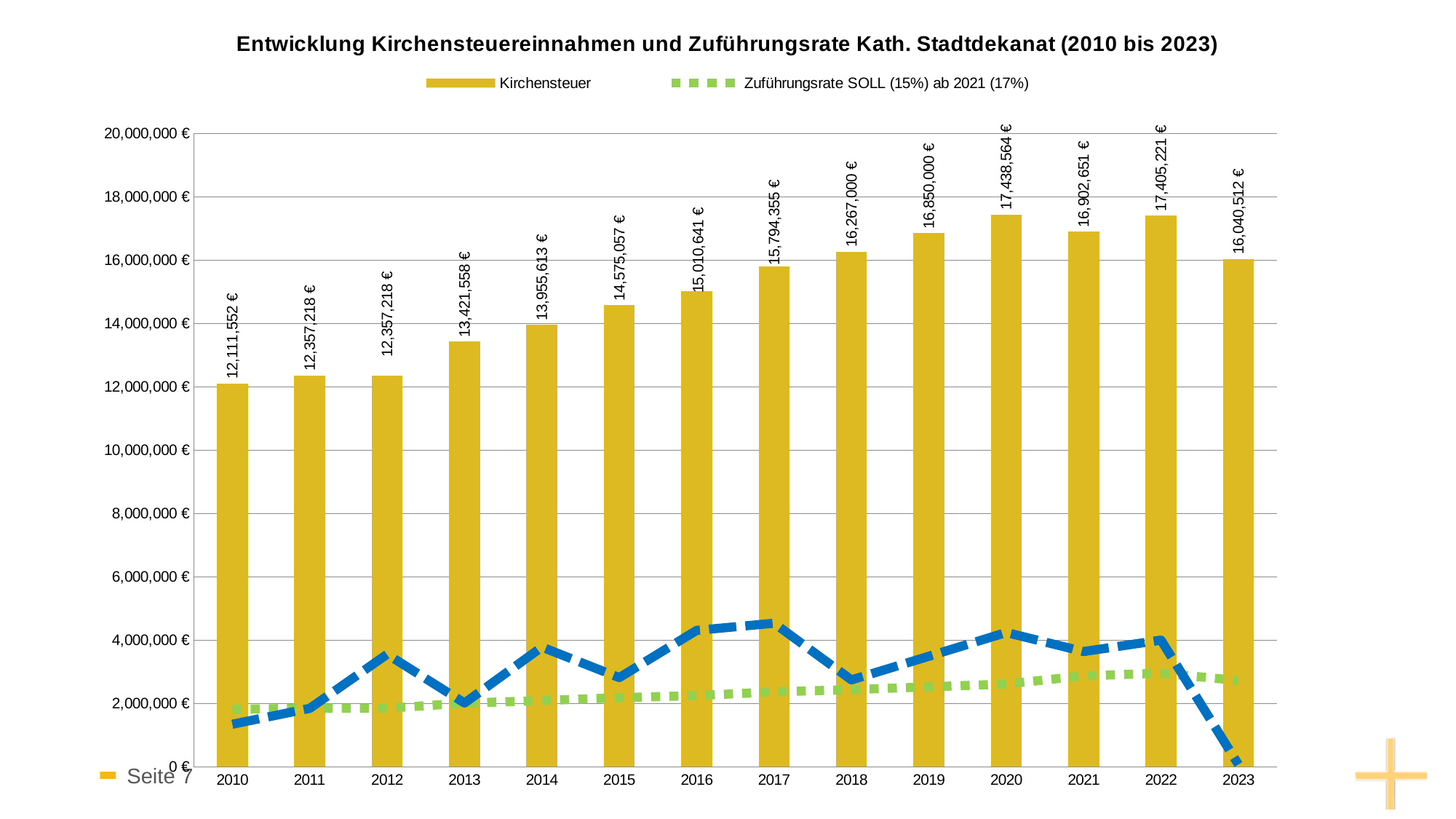
What is the difference between the Kirchensteuer values for 2020 and 2010? 5,327,012 € How many years are shown on the x axis? 14 Which year has the larger Kirchensteuer value, 2021 or 2022? 2022 What is the Kirchensteuer value for 2010? 12,111,552 € What is the Kirchensteuer value for 2023? 16,040,512 € By how much did Kirchensteuer fall from 2022 to 2023? 1,364,709 € Which year has the highest Kirchensteuer value? 2020 Do the Kirchensteuer bars generally rise or fall from 2010 to 2020? rise How many series does the legend list? 2 Which year has the lowest Kirchensteuer value? 2010 What is the Kirchensteuer value for 2017? 15,794,355 € Is the value of the blue dashed line for 2017 greater or less than 4,000,000 €? greater